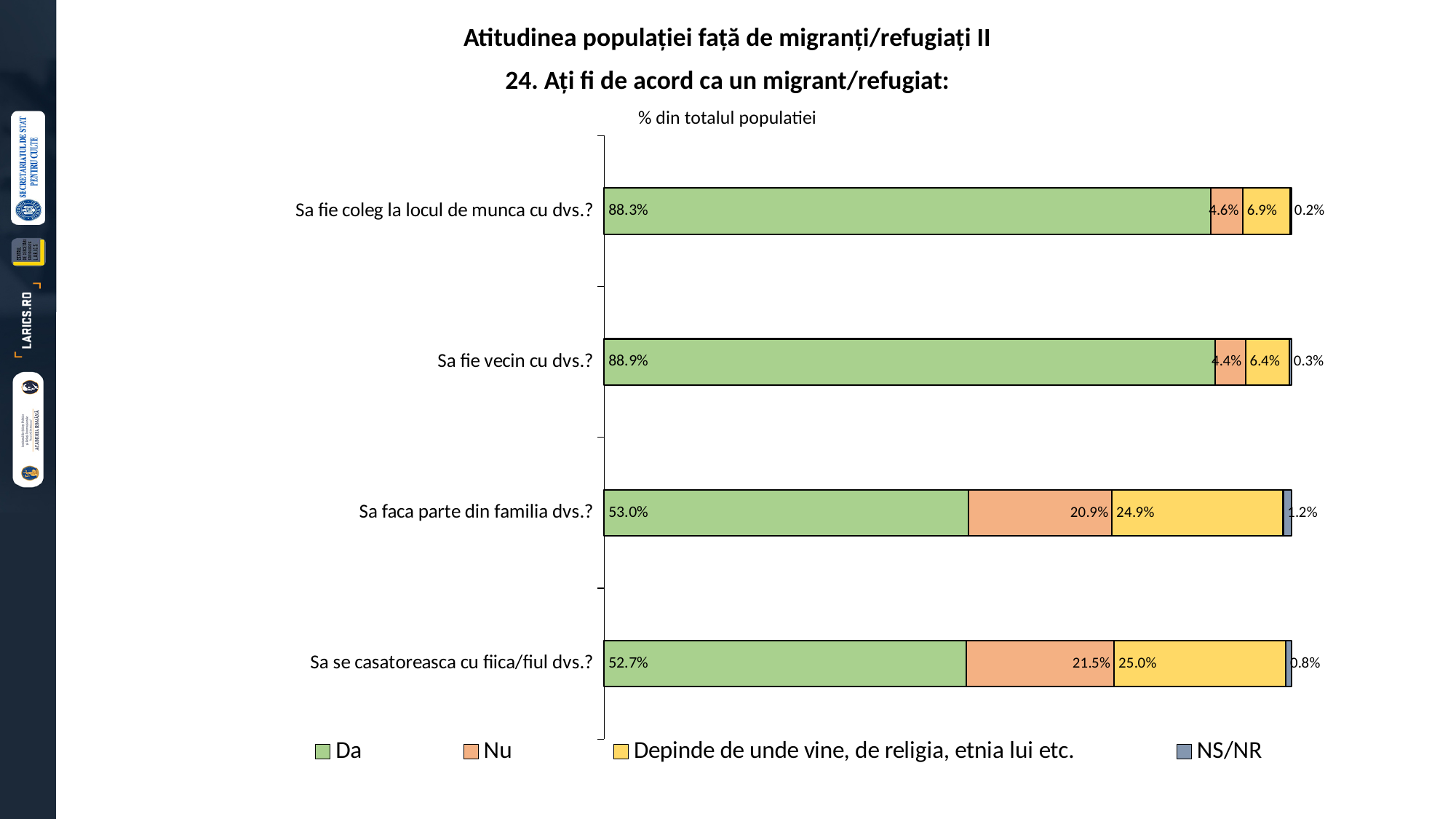
Which category has the highest 'Da' value? Sa fie vecin cu dvs.? What kind of chart is shown on the slide? Stacked bar chart What is the value of the 'NS/NR' series for 'Sa fie coleg la locul de munca cu dvs.?'? 0.2% How many series does the legend list? 4 Which has the larger 'Nu' value: 'Sa se casatoreasca cu fiica/fiul dvs.?' or 'Sa faca parte din familia dvs.?'? Sa se casatoreasca cu fiica/fiul dvs.? Which category has the lowest 'Da' value? Sa se casatoreasca cu fiica/fiul dvs.? What is the value of the 'Nu' series for 'Sa faca parte din familia dvs.?'? 20.9% What is the difference between the 'Da' values for 'Sa fie coleg la locul de munca cu dvs.?' and 'Sa faca parte din familia dvs.?'? 35.3 percentage points What is the value of the 'Depinde de unde vine, de religia, etnia lui etc.' series for 'Sa se casatoreasca cu fiica/fiul dvs.?'? 25.0% What is the value of the 'Da' series for 'Sa fie vecin cu dvs.?'? 88.9% What is the total of the stacked bar for 'Sa fie vecin cu dvs.?'? 100.0% How many categories (questions) are shown on the chart? 4